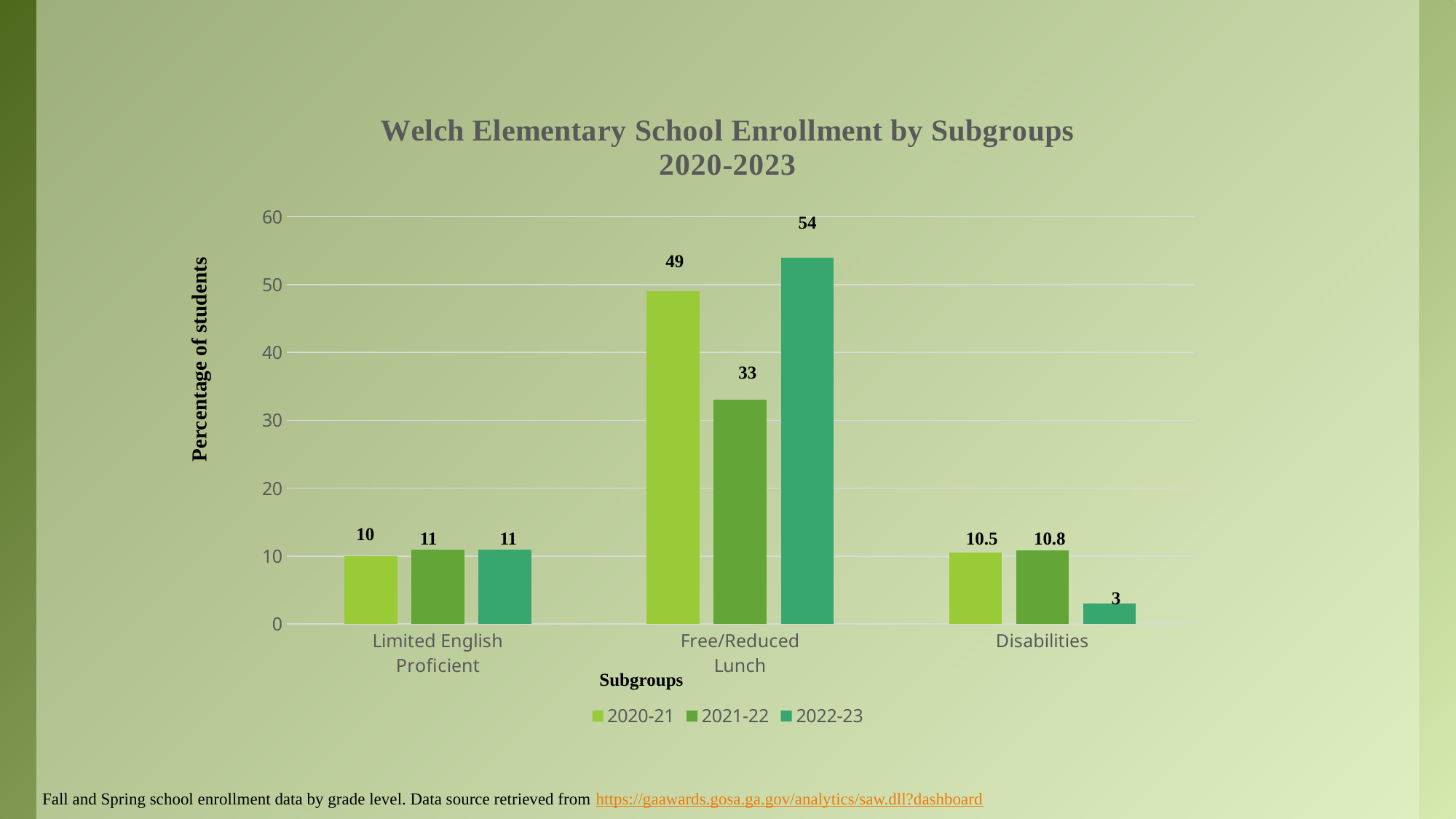
What kind of chart is shown on the slide? bar chart What is the value for Free/Reduced Lunch in 2022-23? 54 What is the difference between the 2022-23 and 2021-22 values for Free/Reduced Lunch? 21 What is the value for Limited English Proficient in 2020-21? 10 What is the value for Disabilities in 2021-22? 10.8 How many subgroups are shown on the x axis? 3 Which subgroup has the lowest value in 2022-23? Disabilities How many series does the legend list? 3 Which subgroup has the highest value in 2020-21? Free/Reduced Lunch What is the title of the chart? Welch Elementary School Enrollment by Subgroups 2020-2023 Which is larger for Disabilities: the 2020-21 value or the 2022-23 value? 2020-21 Is the value for Free/Reduced Lunch in 2021-22 greater or less than 40? less